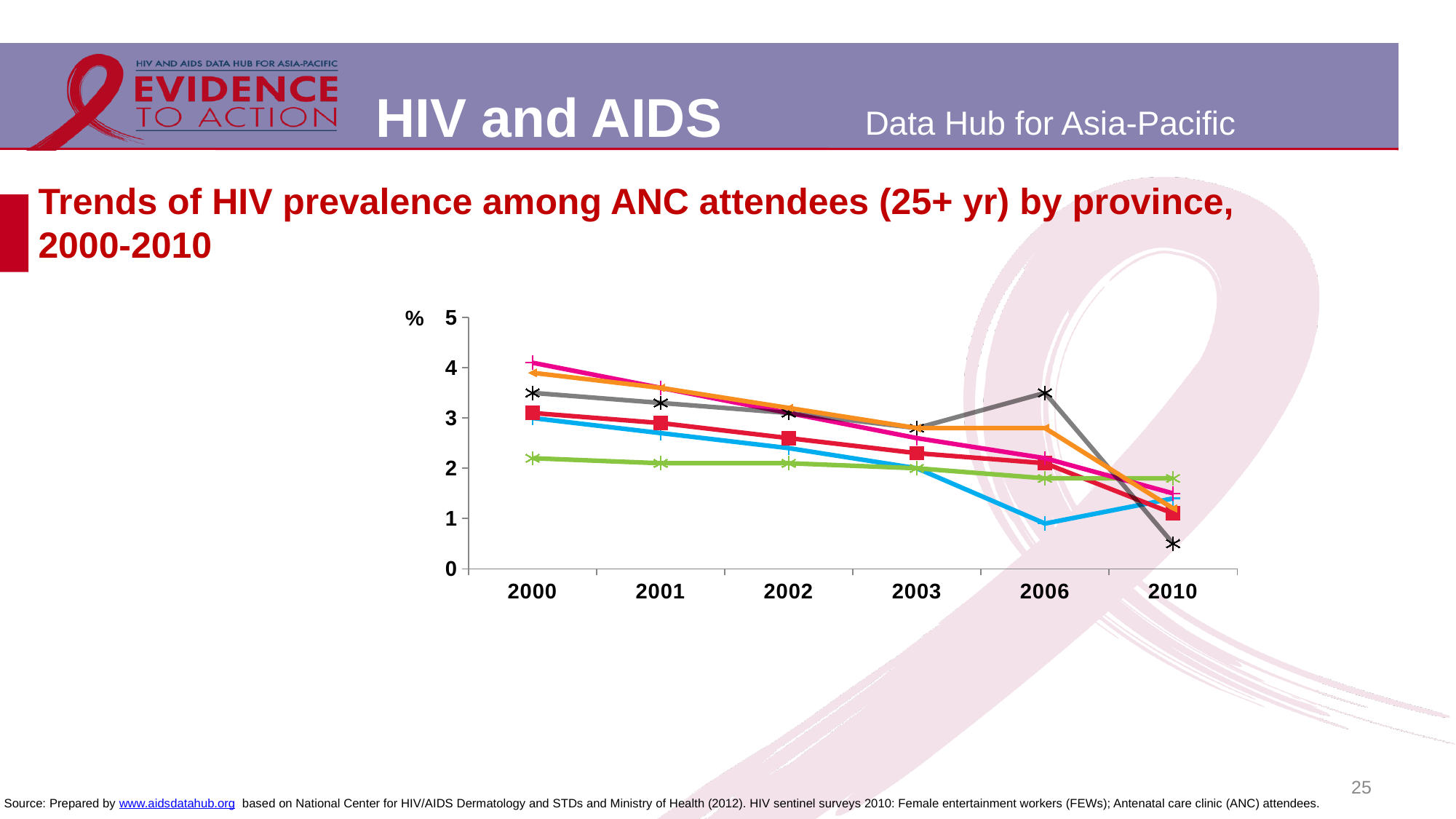
Is the value of the orange line in 2006 greater or less than 3? less Which line has the lowest value in 2000? the green line What unit is shown on the y axis of the chart? % Is the value of the green line in 2010 greater or less than 2? less What is the title of the chart on the slide? Trends of HIV prevalence among ANC attendees (25+ yr) by province, 2000-2010 Is the value of the black line in 2010 greater or less than 1? less How many years are shown on the x axis of the chart? 6 Which line has the lowest value in 2010? the black line Which line has the highest value in 2006? the black line How many lines are plotted on the chart? 6 What kind of chart is shown on the slide? line chart